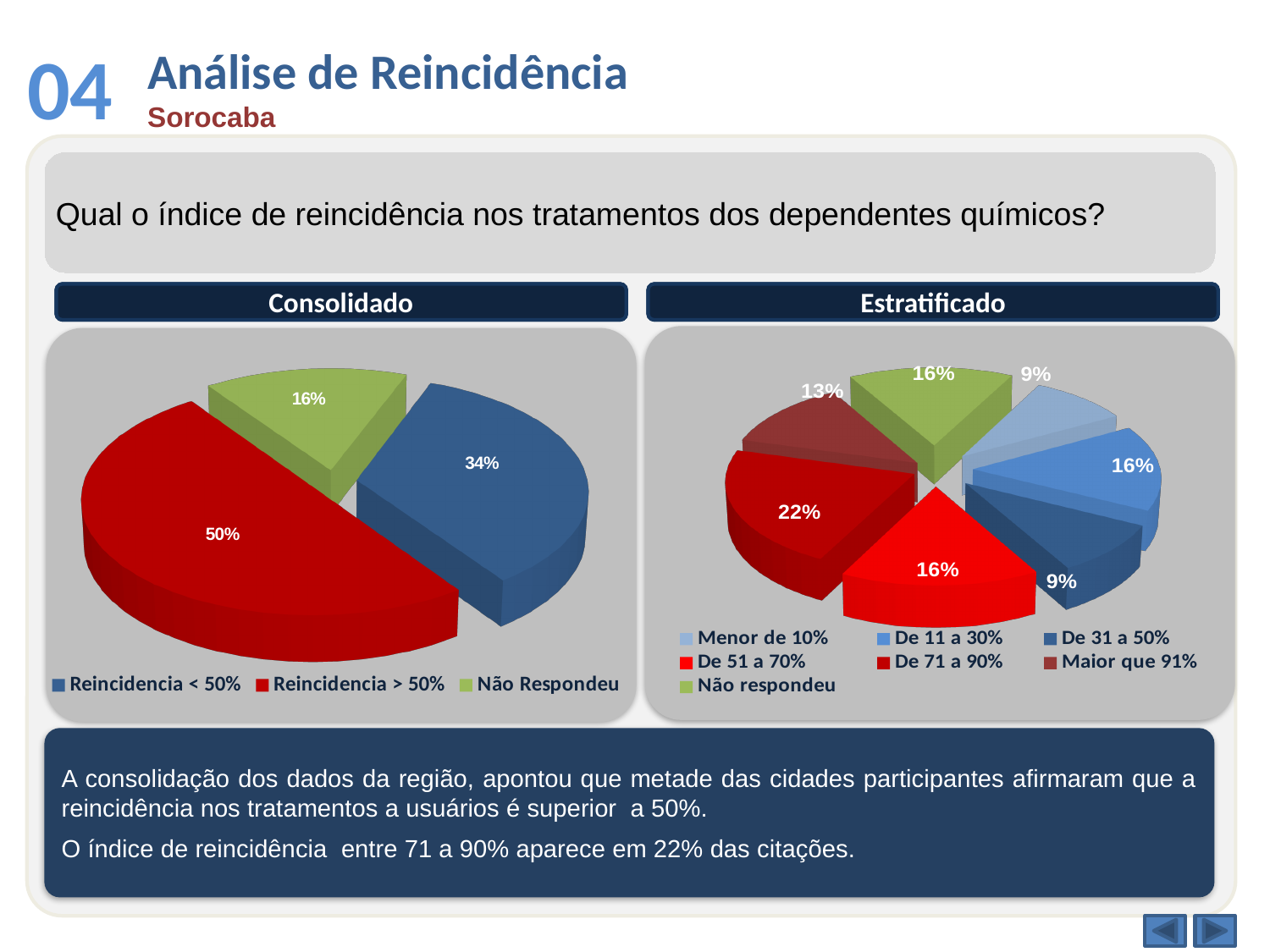
In the Consolidado chart, what is the difference between Reincidencia > 50% and Reincidencia < 50%? 16% In the Estratificado chart, what percentage is shown for Maior que 91%? 13% In the Estratificado chart, what is the difference between De 71 a 90% and Menor de 10%? 13% In the Consolidado chart, what percentage is shown for Reincidencia < 50%? 34% In the Consolidado chart, which category has the largest slice? Reincidencia > 50% How many categories does the legend of the Estratificado chart list? 7 In the Consolidado chart, what percentage is shown for Reincidencia > 50%? 50% In the Estratificado chart, what percentage is shown for De 71 a 90%? 22% In the Consolidado chart, what percentage is shown for Não Respondeu? 16% In the Estratificado chart, which category has the largest slice? De 71 a 90% In the Estratificado chart, which is larger: De 71 a 90% or Maior que 91%? De 71 a 90% What kind of chart is the Consolidado chart? Pie chart